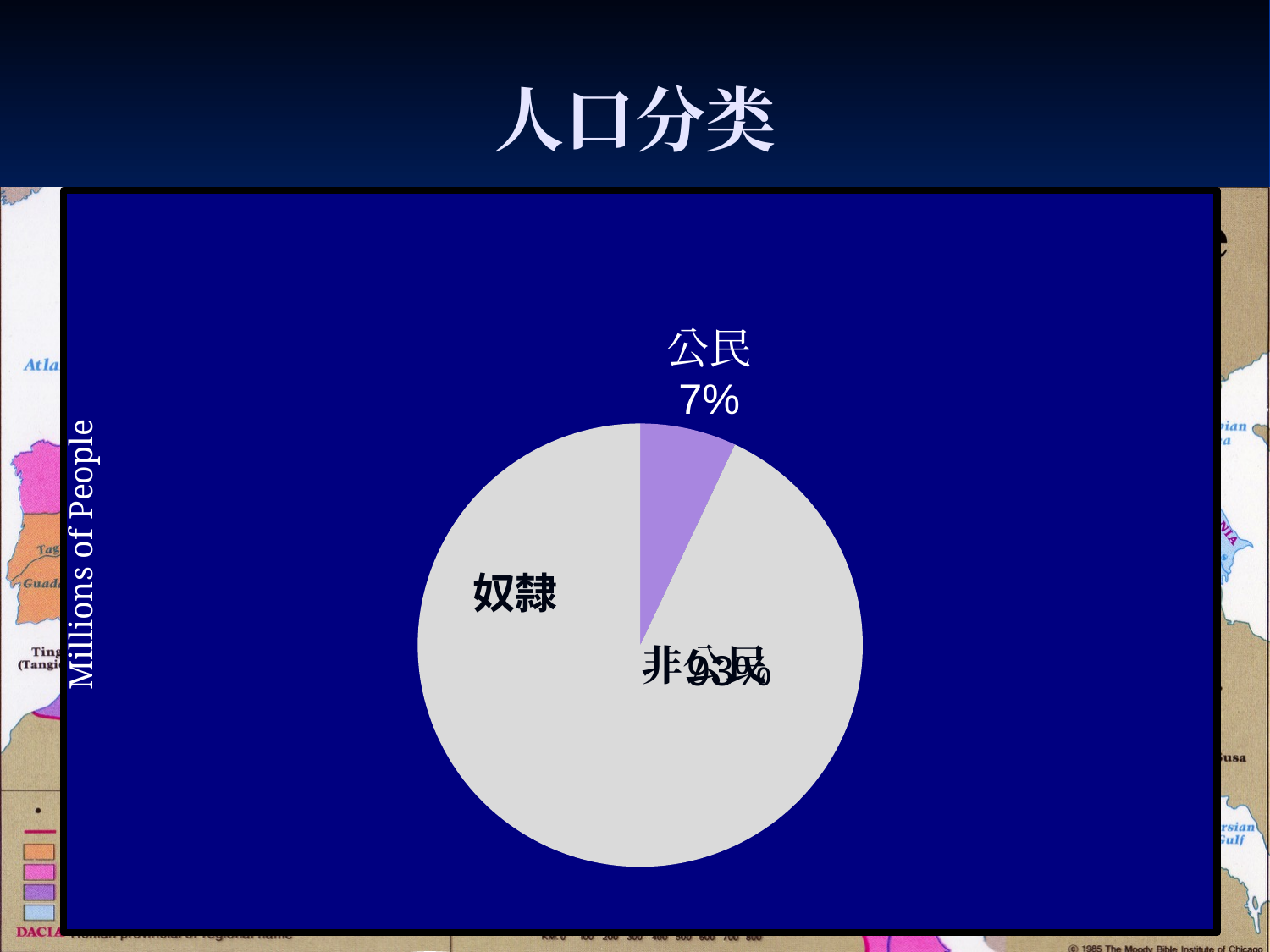
Which slice of the pie is the largest? 非公民 What colour is the 公民 slice of the pie? purple What share of the pie does 非公民 represent? 93% How many slices does the pie chart have? 2 What share of the pie does 公民 represent? 7% What kind of chart is shown on the slide? pie chart What is the title of the slide containing the pie chart? 人口分类 What is the difference in percentage points between the 非公民 slice and the 公民 slice? 86 Which slice of the pie is the smallest? 公民 Which is larger, the 公民 slice or the 非公民 slice? 非公民